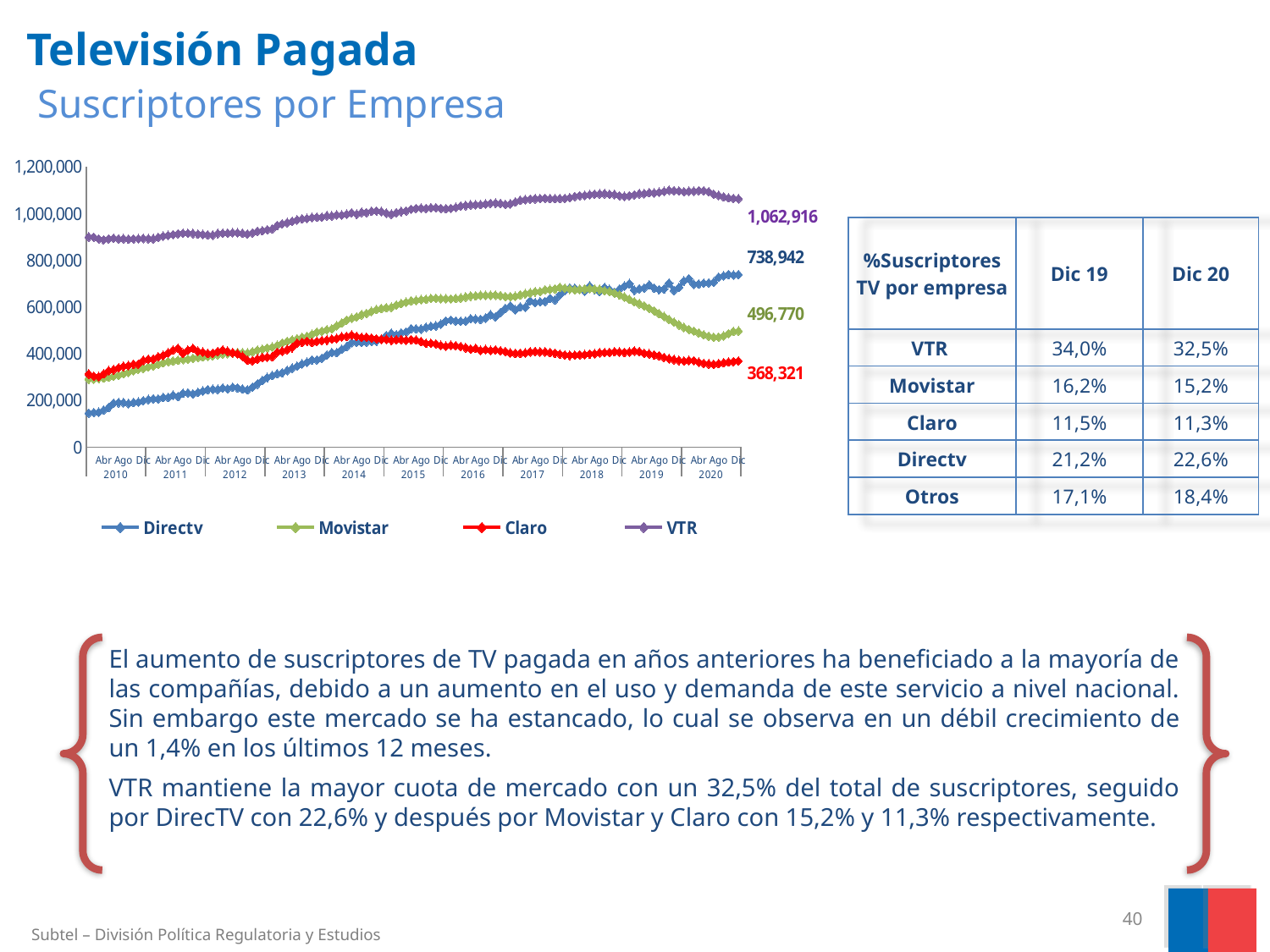
What is the final labelled value for Movistar on the chart? 496,770 What is the difference between the final labelled values of VTR and Directv? 323,974 What is the final labelled value for VTR on the chart? 1,062,916 Which series has the lowest value at the end of the chart? Claro Is the value for Claro in 2010 greater or less than 400,000? less Does the Directv series generally rise or fall from 2010 to 2020? rise Which series has the highest value at the end of the chart? VTR What is the final labelled value for Claro on the chart? 368,321 Which is larger at the end of the chart, Movistar or Claro? Movistar What kind of chart is shown on the slide? line chart How many series does the chart legend list? 4 What is the final labelled value for Directv on the chart? 738,942